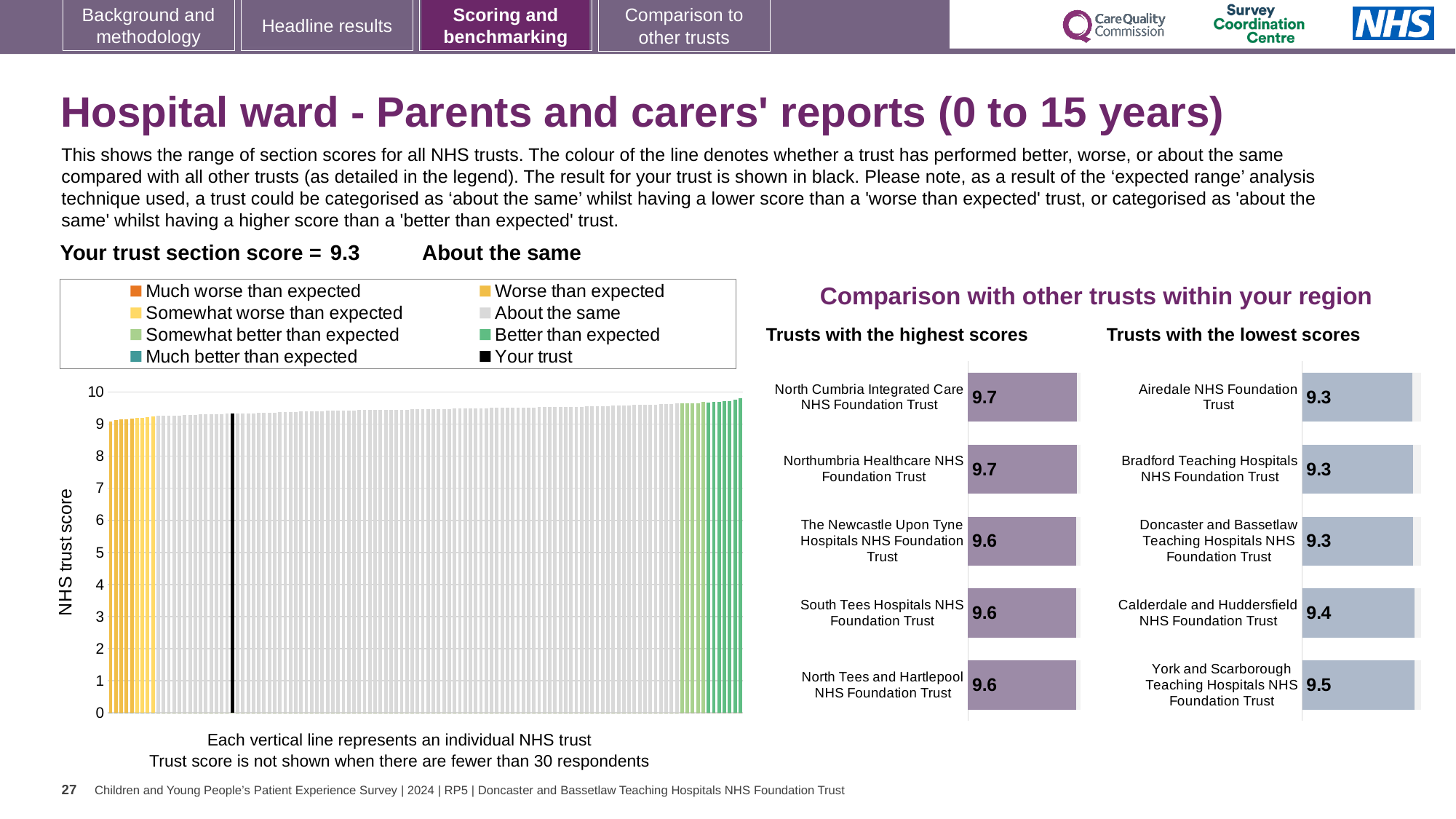
In the large chart on the left, do the trust scores rise or fall from left to right along the x axis? rise In the 'Trusts with the highest scores' chart, which has the larger score: Northumbria Healthcare NHS Foundation Trust or North Tees and Hartlepool NHS Foundation Trust? Northumbria Healthcare NHS Foundation Trust In the large chart on the left, is the value for the black bar (your trust) greater or less than 9? greater What type of chart is the large chart on the left showing NHS trust scores? bar chart In the 'Trusts with the lowest scores' chart, what is the score for Calderdale and Huddersfield NHS Foundation Trust? 9.4 How many trusts are shown in the 'Trusts with the highest scores' chart? 5 In the 'Trusts with the lowest scores' chart, which trust has the highest score? York and Scarborough Teaching Hospitals NHS Foundation Trust How many entries does the legend above the large chart on the left list? 8 In the 'Trusts with the lowest scores' chart, what is the difference between the scores for York and Scarborough Teaching Hospitals NHS Foundation Trust and Airedale NHS Foundation Trust? 0.2 In the large chart on the left, what is the label on the vertical axis? NHS trust score In the 'Trusts with the highest scores' chart, what is the score for North Cumbria Integrated Care NHS Foundation Trust? 9.7 In the 'Trusts with the highest scores' chart, what is the score for South Tees Hospitals NHS Foundation Trust? 9.6